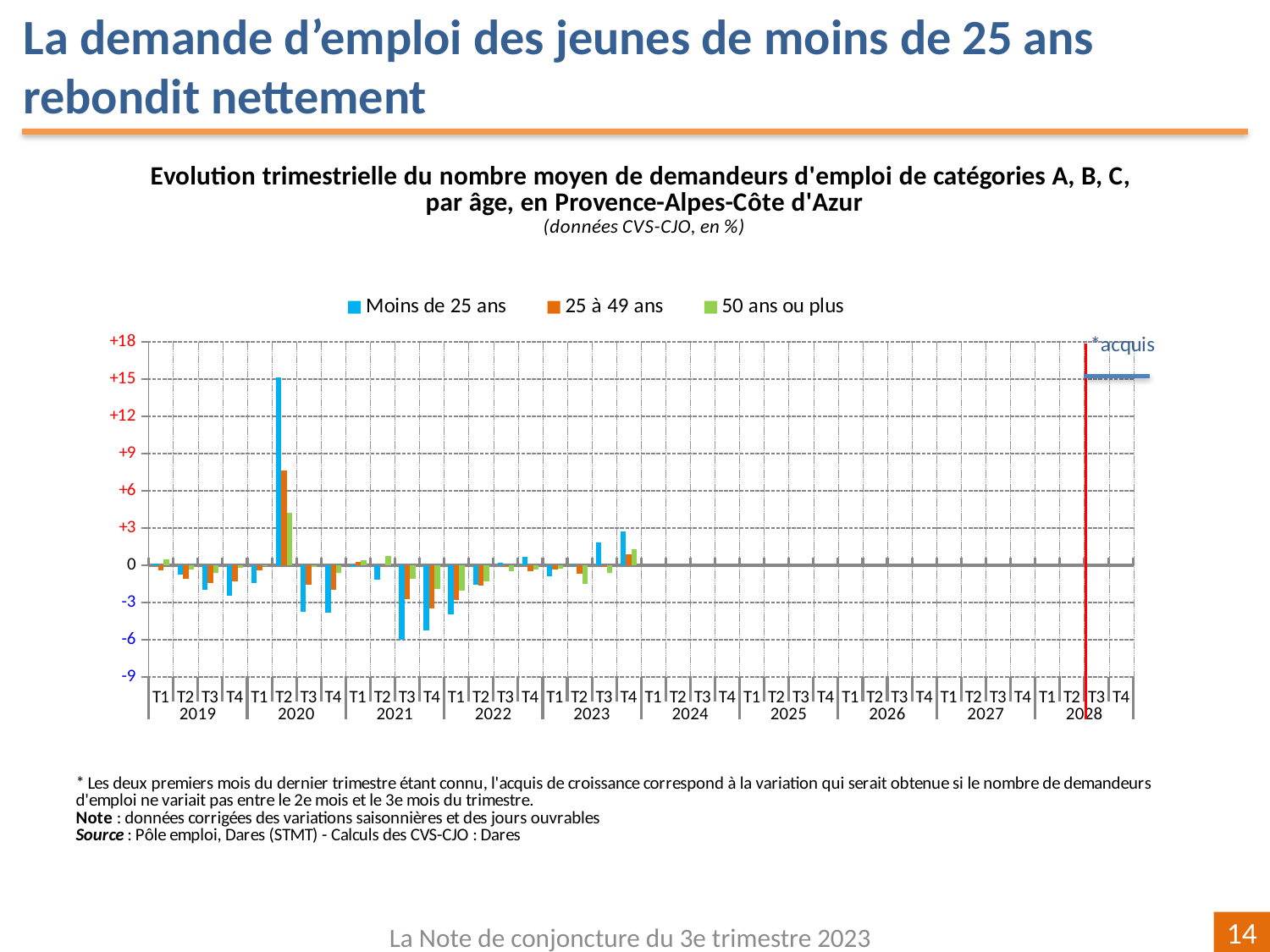
What are the three series named in the legend? Moins de 25 ans, 25 à 49 ans, 50 ans ou plus What kind of chart is shown on the slide? bar chart Is the value for '25 à 49 ans' in T2 2020 greater or less than +6? greater In which quarter does the 'Moins de 25 ans' series reach its lowest value? T3 2021 Is the value for 'Moins de 25 ans' in T2 2020 greater or less than +12? greater In T3 2021, which series has the lower value: 'Moins de 25 ans' or '25 à 49 ans'? Moins de 25 ans In which quarter does the 'Moins de 25 ans' series reach its highest value? T2 2020 In T2 2020, which series has the larger value: 'Moins de 25 ans' or '50 ans ou plus'? Moins de 25 ans How many series does the legend list? 3 Is the value for 'Moins de 25 ans' in T3 2021 greater or less than -3? less How many years are labelled along the x axis of the chart? 10